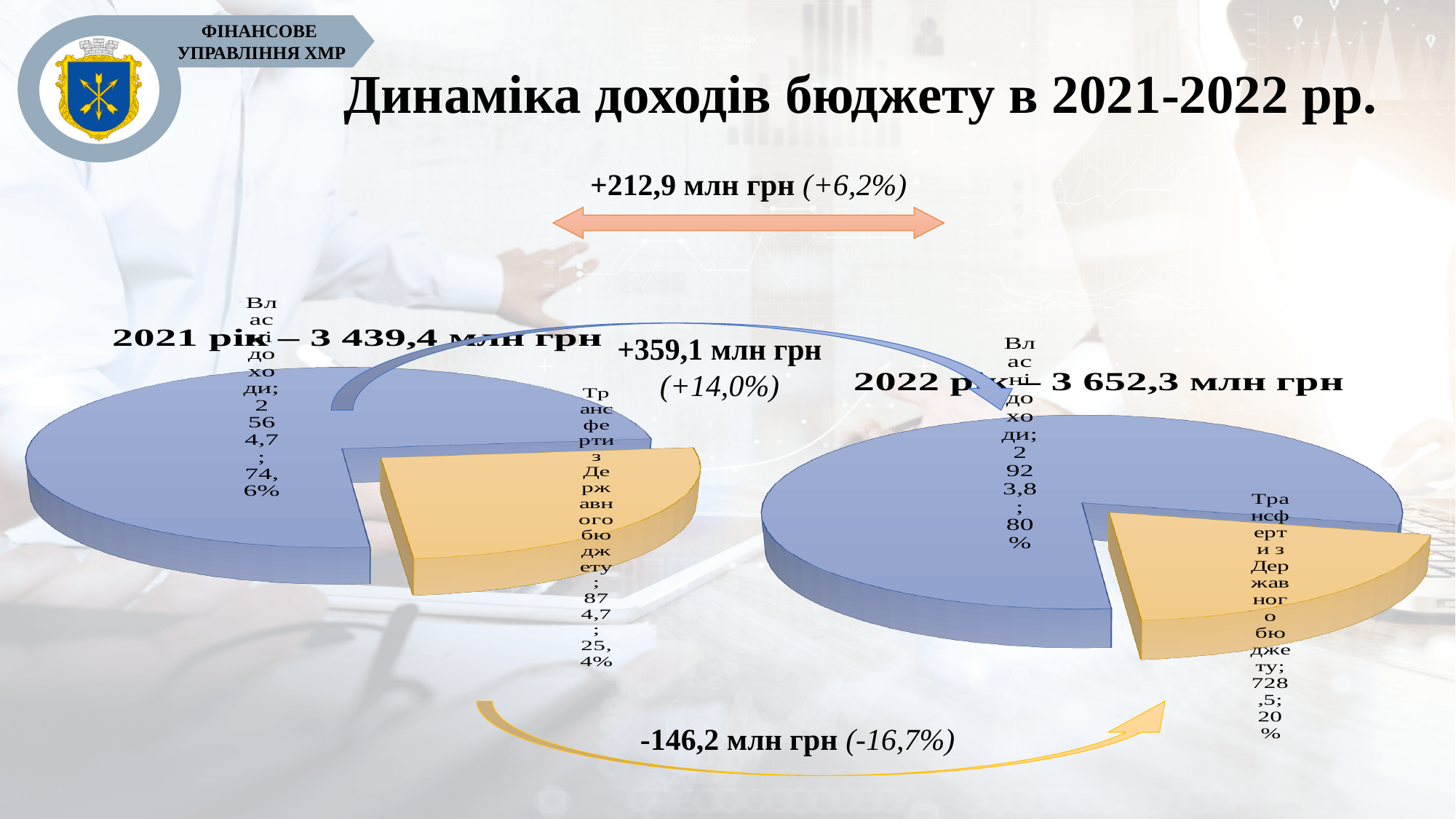
On the 2021 pie chart (left), what share of the pie is 'Трансферти з Державного бюджету'? 25,4% On the 2021 pie chart (left), what is the value of the 'Власні доходи' slice? 2 564,7 On the 2022 pie chart (right), what is the value of the 'Трансферти з Державного бюджету' slice? 728,5 How many slices does the 2022 pie chart (right) have? 2 Which is larger: 'Власні доходи' on the 2021 pie chart (left) or 'Власні доходи' on the 2022 pie chart (right)? 2022 pie chart (right) On the 2022 pie chart (right), which slice is the smallest? Трансферти з Державного бюджету On the 2021 pie chart (left), what is the difference between the 'Власні доходи' value and the 'Трансферти з Державного бюджету' value? 1 690,0 On the 2021 pie chart (left), which slice is the largest? Власні доходи What type of chart is used for the 2021 data on the left? Pie chart On the 2022 pie chart (right), what share of the pie is 'Власні доходи'? 80% What colour is the 'Трансферти з Державного бюджету' slice on both pie charts? Yellow/orange What total is stated for the 2022 pie chart (right)? 3 652,3 млн грн